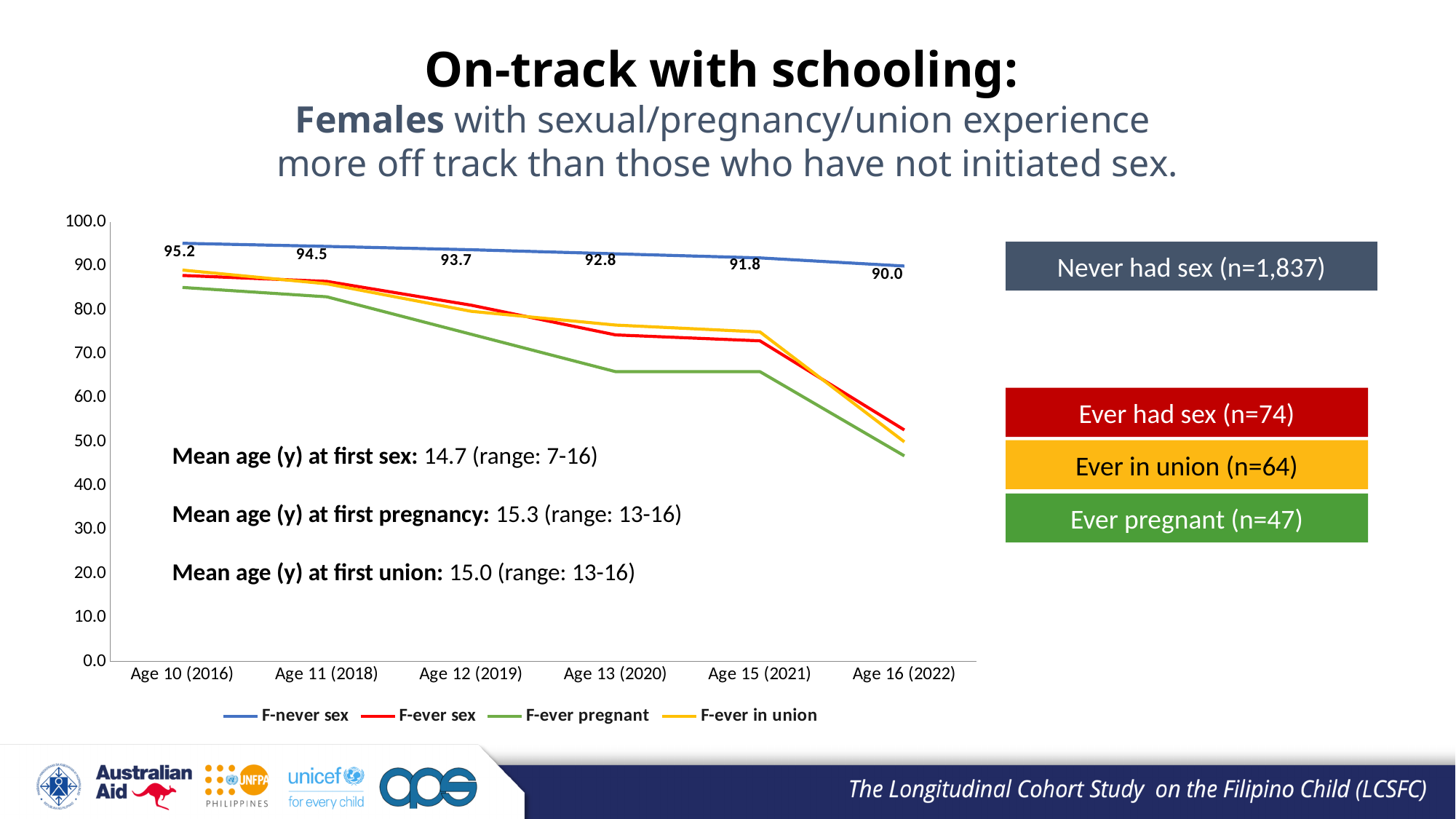
Which series has the highest value at Age 15 (2021)? F-never sex What type of chart is shown on the slide? line chart Is the value for F-ever pregnant at Age 13 (2020) greater or less than 70.0? less How many series does the chart legend list? 4 How many age points are shown along the x axis of the chart? 6 Which colour is used for the F-ever in union line? yellow What is the value for F-never sex at Age 13 (2020)? 92.8 Which series has the lowest value at Age 16 (2022)? F-ever pregnant What is the value for F-never sex at Age 10 (2016)? 95.2 What is the difference between the F-never sex values at Age 10 (2016) and Age 16 (2022)? 5.2 What is the value for F-never sex at Age 16 (2022)? 90.0 Does the F-never sex series rise or fall from Age 10 (2016) to Age 16 (2022)? fall